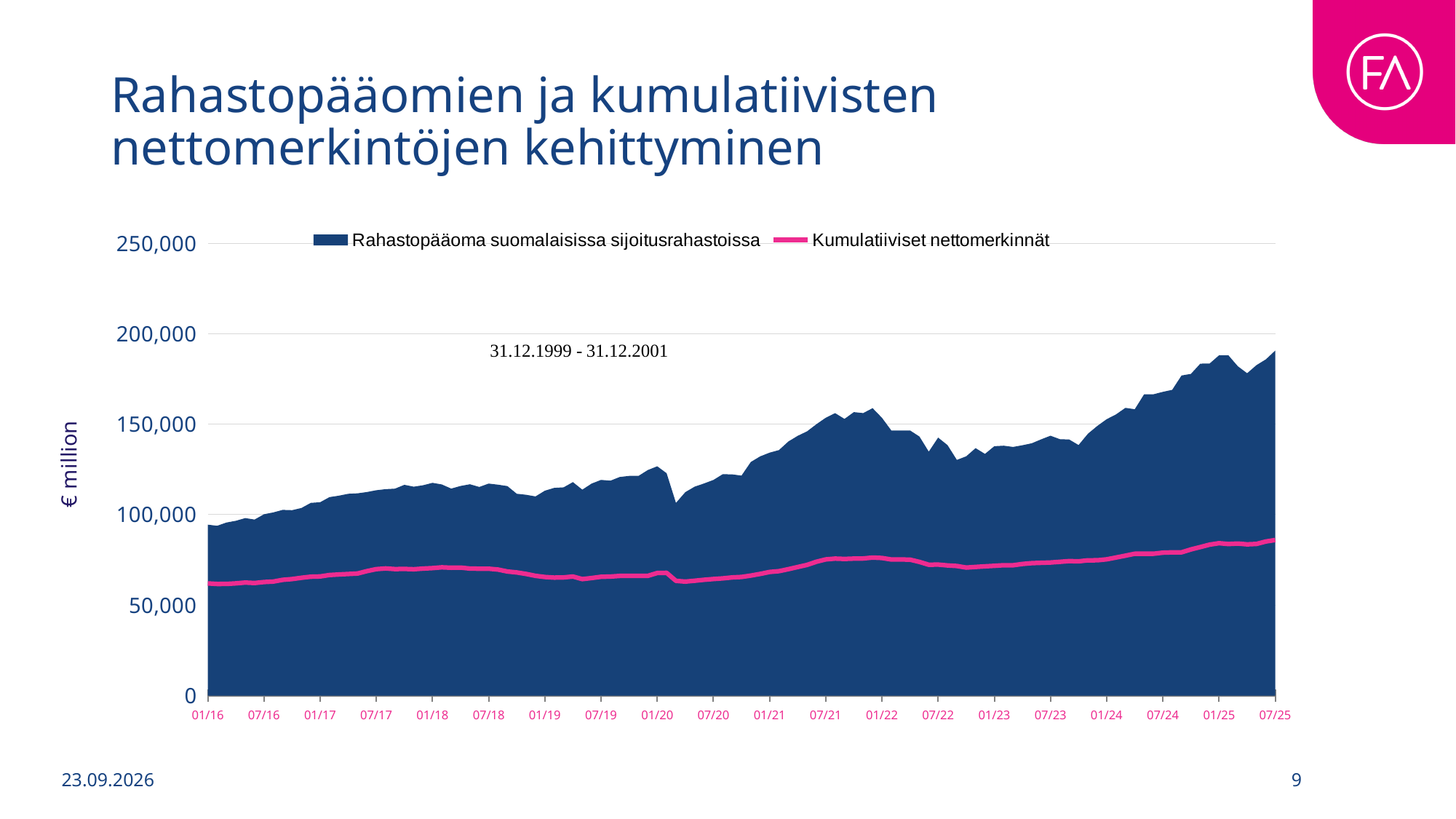
How many series does the chart legend list? 2 Does the Rahastopääoma suomalaisissa sijoitusrahastoissa series overall rise or fall from 01/16 to 07/25? rise Is the value of Rahastopääoma suomalaisissa sijoitusrahastoissa at 07/25 greater or less than 150,000? greater What kind of chart is used for the series Kumulatiiviset nettomerkinnät? Line chart What is the label on the y axis of the chart? € million What colour is the Kumulatiiviset nettomerkinnät line in the chart? Pink Is the value of Kumulatiiviset nettomerkinnät at 07/25 greater or less than 100,000? less At 07/25, which series has the larger value: Rahastopääoma suomalaisissa sijoitusrahastoissa or Kumulatiiviset nettomerkinnät? Rahastopääoma suomalaisissa sijoitusrahastoissa What kind of chart is used for the series Rahastopääoma suomalaisissa sijoitusrahastoissa? Area chart Is the value of Rahastopääoma suomalaisissa sijoitusrahastoissa at 01/16 greater or less than 100,000? less